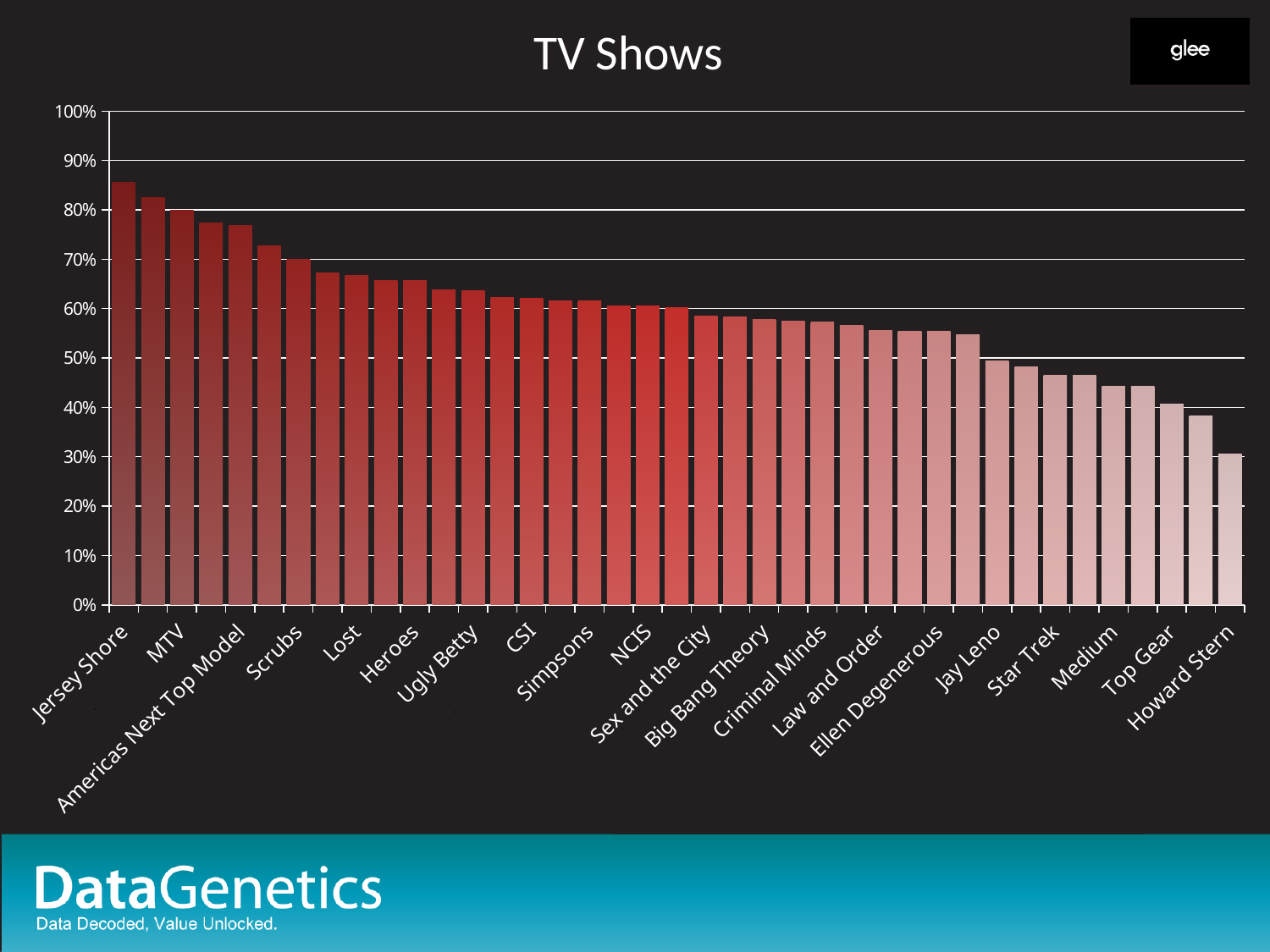
Is the value for Jersey Shore greater or less than 80%? greater Do the values rise or fall moving from left to right along the x axis? fall Which TV show has the lowest value in the chart? Howard Stern Which TV show has the highest value in the chart? Jersey Shore Is the value for Big Bang Theory greater or less than 60%? less Which has the larger value, Star Trek or Heroes? Heroes Which has the larger value, Scrubs or Medium? Scrubs Is the value for Lost greater or less than 70%? less What kind of chart is shown on the slide? bar chart What is the title of the chart? TV Shows